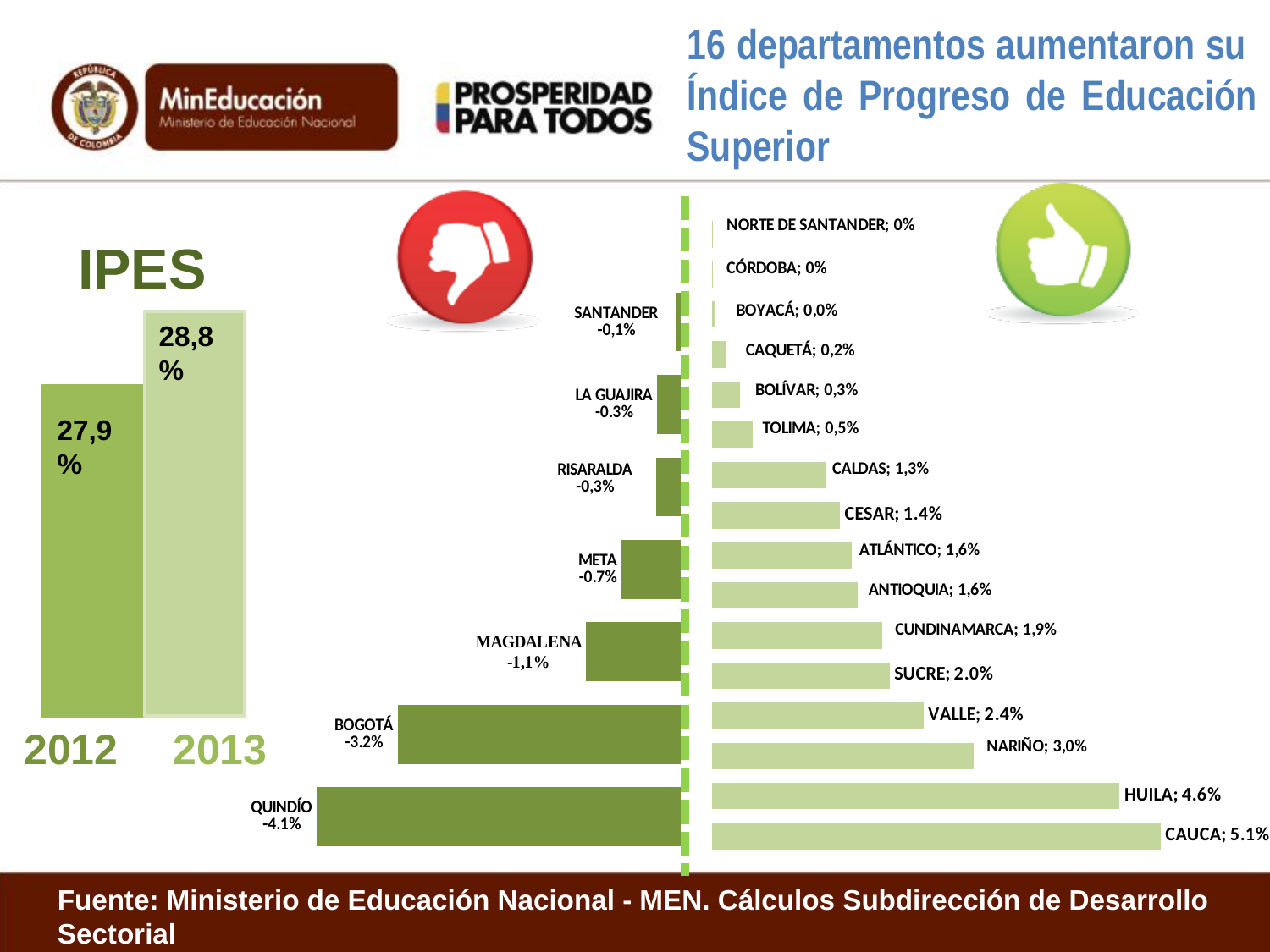
In the IPES chart on the left, what is the value for 2013? 28,8% In the department bar chart on the right, which department has the highest value? CAUCA In the department bar chart on the right, which department has the lowest value? QUINDÍO In the department bar chart on the right, what is the value for MAGDALENA? -1,1% In the department bar chart on the right, what is the value for CAUCA? 5.1% In the department bar chart on the right, what is the value for BOGOTÁ? -3.2% In the IPES chart on the left, how many bars are plotted? 2 In the department bar chart on the right, how many departments are plotted? 23 In the IPES chart on the left, what is the value for 2012? 27,9% What kind of chart is the department chart on the right? bar chart In the department bar chart on the right, which is larger, the value for HUILA or the value for NARIÑO? HUILA In the IPES chart on the left, which year has the higher value, 2012 or 2013? 2013